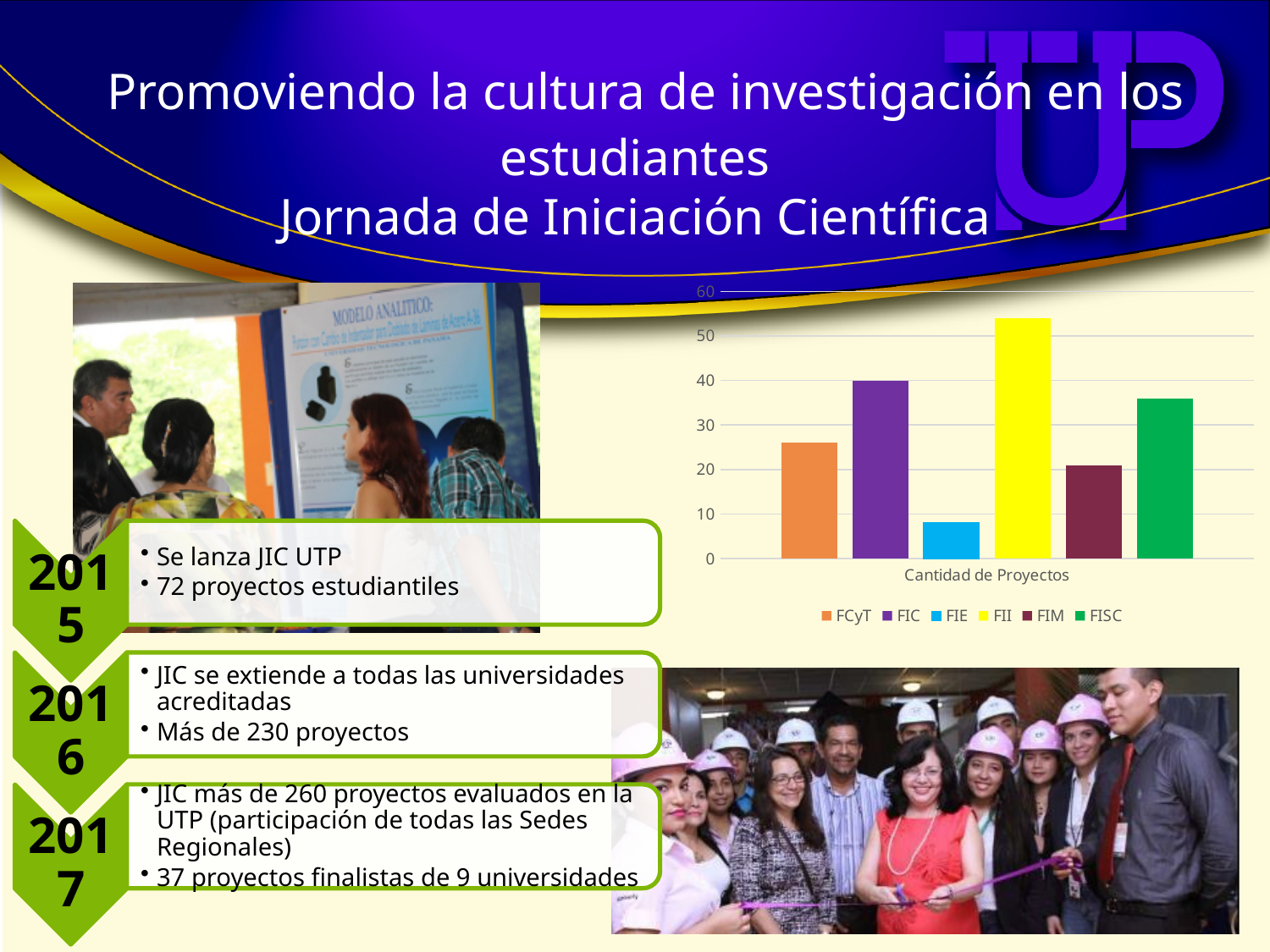
Is the value for FISC greater or less than 30? greater Is the value for FII greater or less than 50? greater What is the category label shown on the x axis of the chart? Cantidad de Proyectos Which series has the highest bar in the chart? FII How many series does the chart legend list? 6 Which is larger, the value for FIC or the value for FIM? FIC What kind of chart is shown on the slide? bar chart Is the value for FCyT greater or less than 30? less What colour is the bar for FII in the chart? yellow Which is larger, the value for FCyT or the value for FISC? FISC Which series has the lowest bar in the chart? FIE